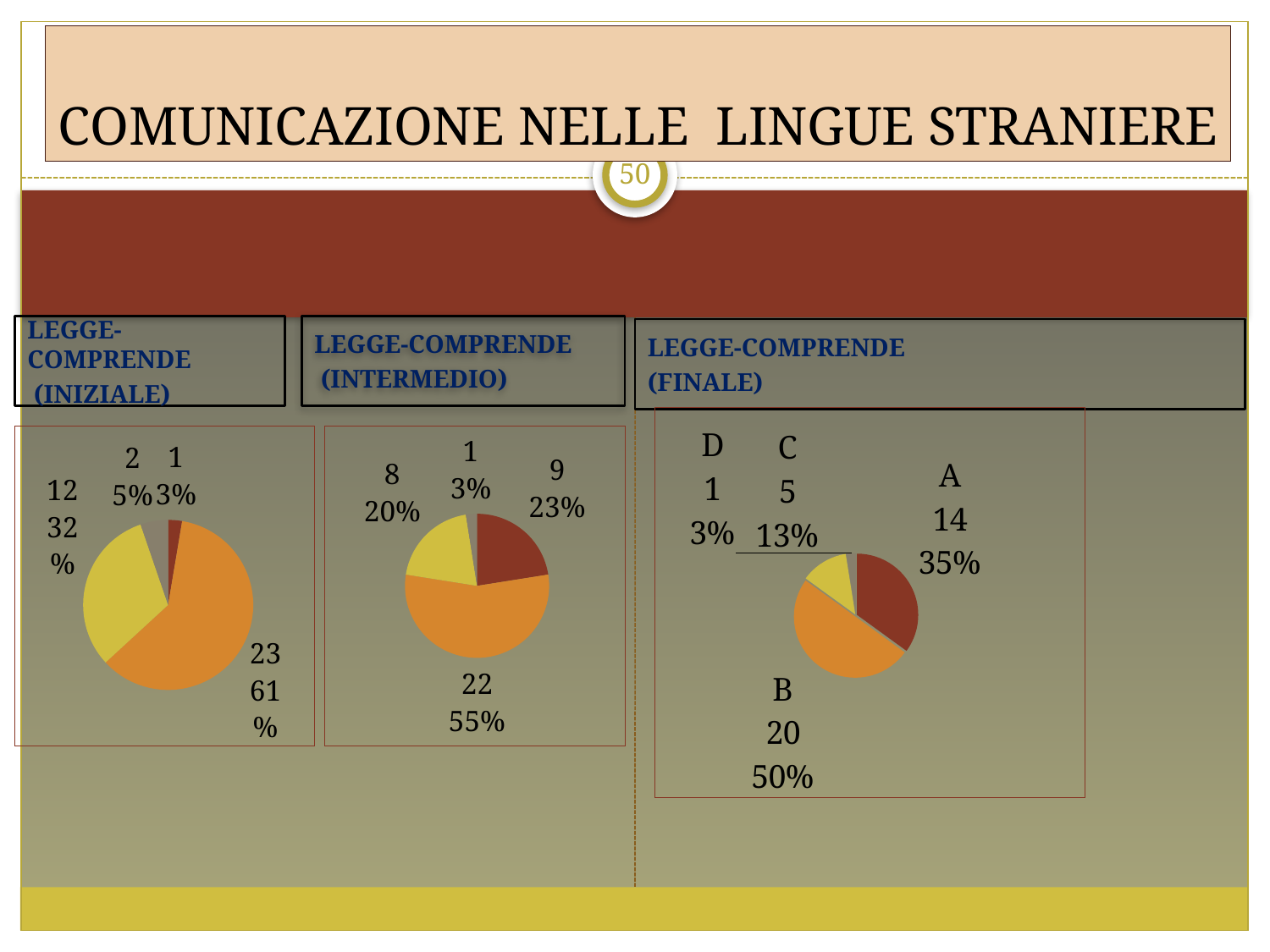
What type of chart is used for LEGGE-COMPRENDE (INIZIALE)? Pie chart How many slices does the LEGGE-COMPRENDE (FINALE) pie chart have? 4 In the LEGGE-COMPRENDE (FINALE) chart, which category has the smallest slice? D In the LEGGE-COMPRENDE (FINALE) chart, what is the difference in count between category B and category A? 6 In the LEGGE-COMPRENDE (INTERMEDIO) chart, what count is shown for the largest slice? 22 In the LEGGE-COMPRENDE (FINALE) chart, which category has the largest slice? B In the LEGGE-COMPRENDE (FINALE) chart, what percentage is shown for category C? 13% In the LEGGE-COMPRENDE (FINALE) chart, what percentage is shown for category B? 50% In the LEGGE-COMPRENDE (FINALE) chart, which is larger, the slice for A or the slice for C? A In the LEGGE-COMPRENDE (INIZIALE) chart, what percentage is shown for the largest slice? 61% In the LEGGE-COMPRENDE (FINALE) chart, what count is shown for category A? 14 How many pie charts are shown on the slide? 3